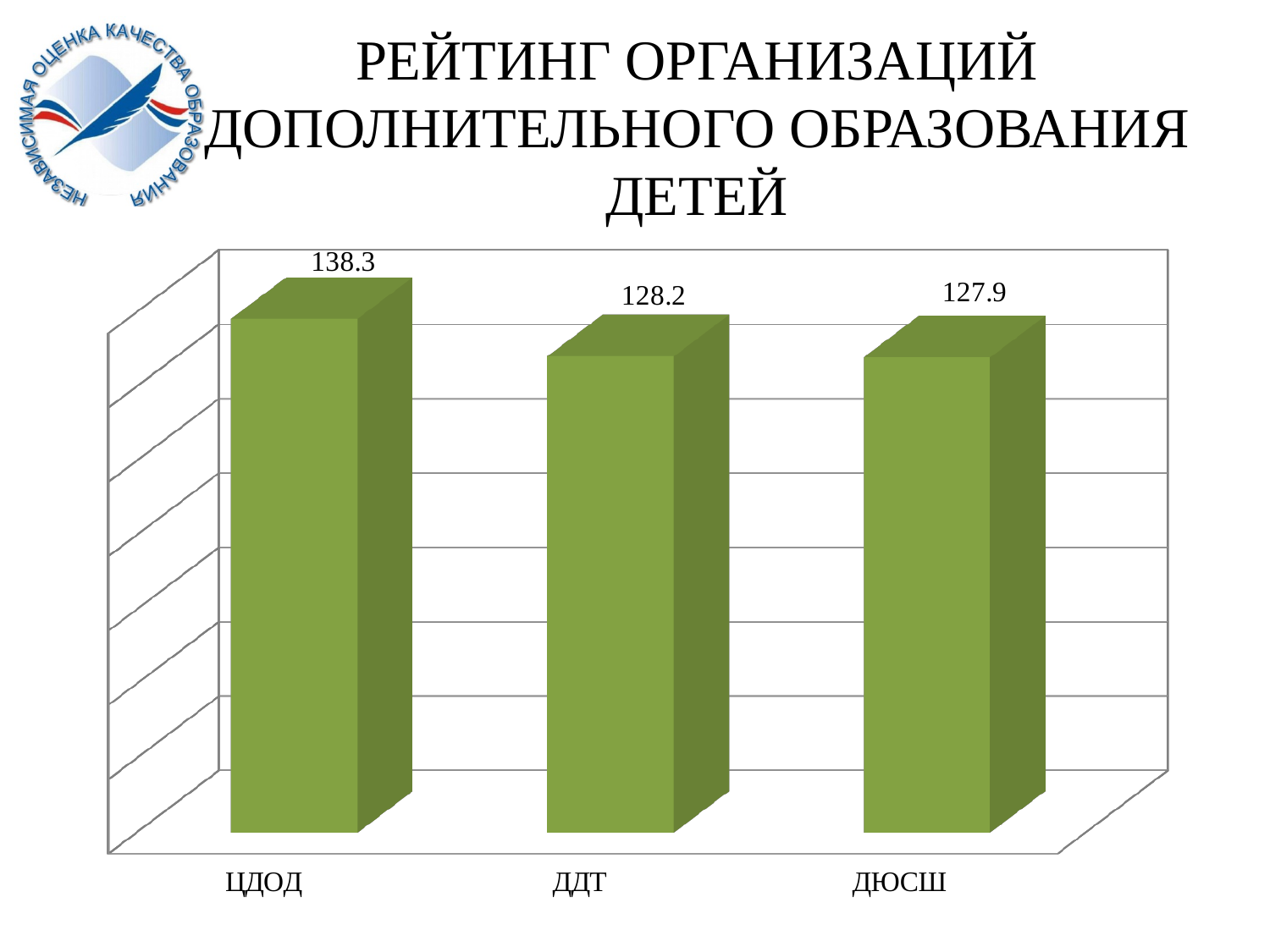
What is the difference between the values for ДДТ and ДЮСШ? 0.3 What is the value for ЦДОД? 138.3 Do the values rise or fall from left to right across the categories? Fall Which category has the highest value? ЦДОД Which category has the lowest value? ДЮСШ What is the difference between the values for ЦДОД and ДДТ? 10.1 What kind of chart is shown on the slide? Bar chart What is the value for ДЮСШ? 127.9 How many categories are shown in the chart? 3 Which is larger, the value for ЦДОД or the value for ДДТ? ЦДОД What is the value for ДДТ? 128.2 What is the difference between the values for ЦДОД and ДЮСШ? 10.4